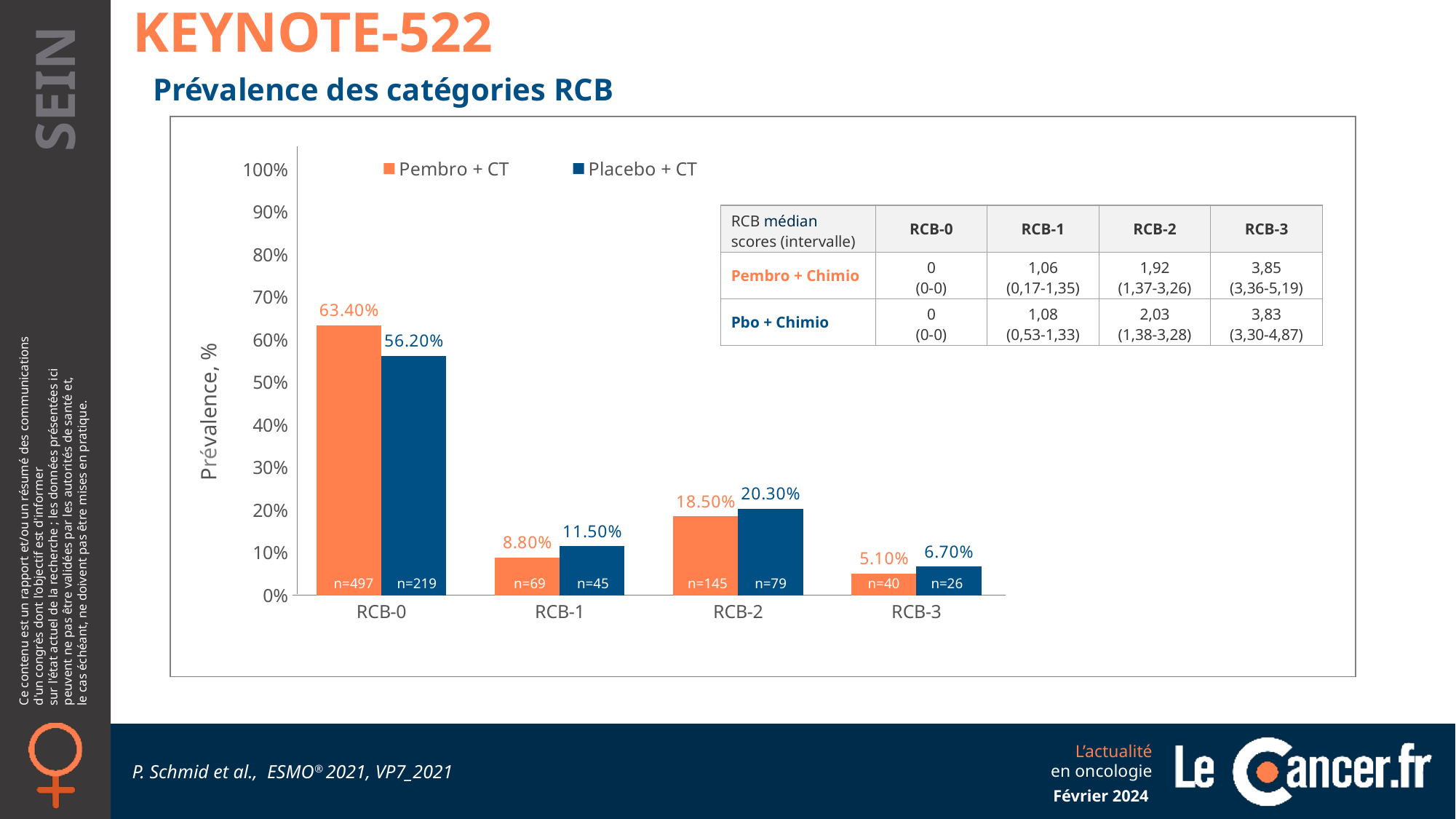
What is the prevalence for Placebo + CT in the RCB-2 category? 20.30% What is the prevalence for Pembro + CT in the RCB-0 category? 63.40% How many RCB categories are shown on the x axis? 4 Which RCB category has the highest prevalence for Pembro + CT? RCB-0 What is the difference between the Pembro + CT and Placebo + CT prevalence in the RCB-0 category? 7.20% How many series does the legend list? 2 In the RCB-1 category, which series has the larger prevalence, Pembro + CT or Placebo + CT? Placebo + CT What is the label of the y axis? Prévalence, % Is the Placebo + CT value for RCB-0 greater or less than 50%? greater What kind of chart is shown on the slide? Bar chart Which RCB category has the lowest prevalence for Placebo + CT? RCB-3 What is the prevalence for Placebo + CT in the RCB-3 category? 6.70%